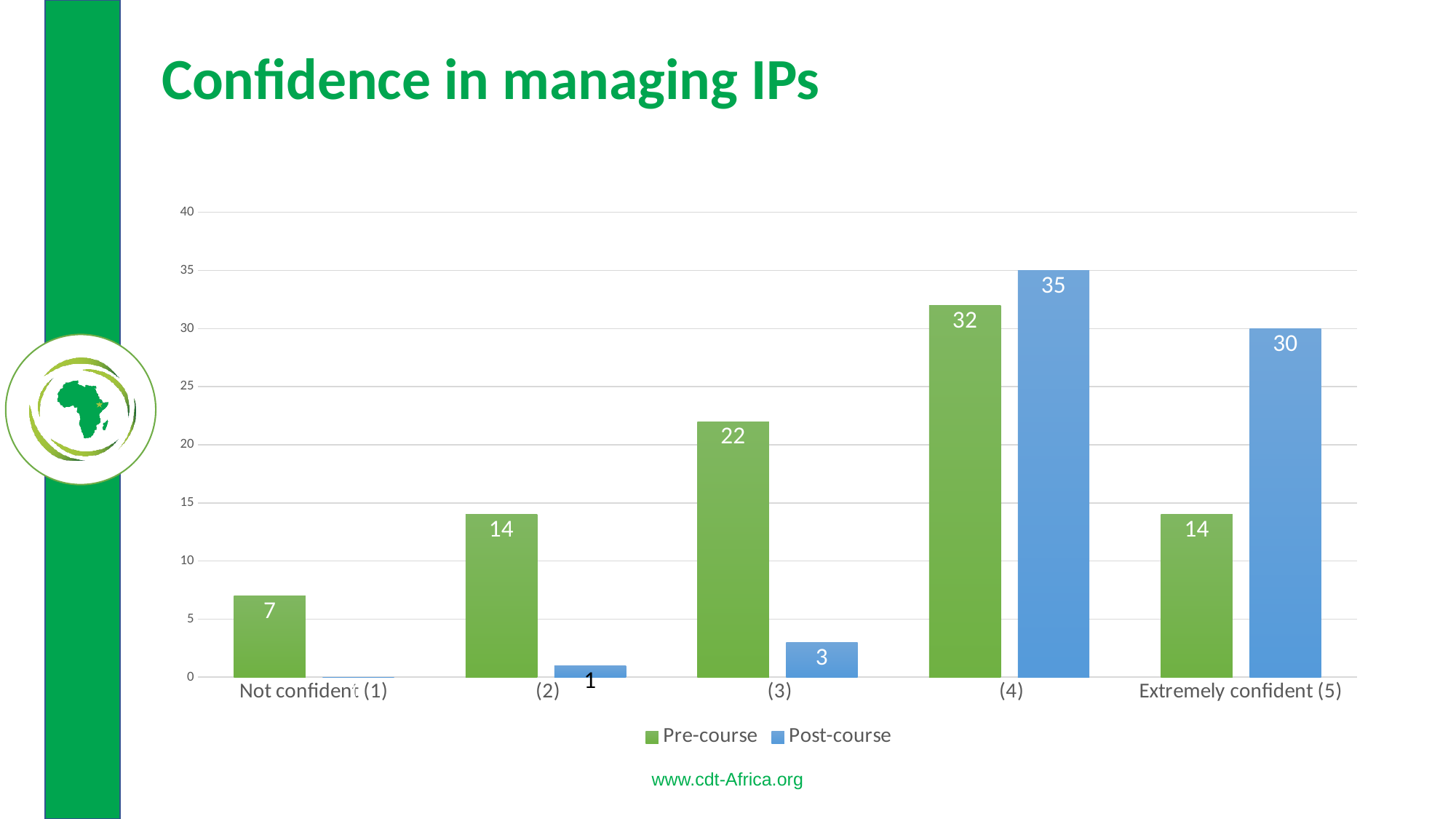
What is the Pre-course value for (3)? 22 What is the Pre-course value for Not confident (1)? 7 Which category has the lowest Pre-course value? Not confident (1) How many series does the legend list? 2 What is the Post-course value for (4)? 35 What is the difference between the Post-course and Pre-course values for Extremely confident (5)? 16 Is the Post-course value for (4) greater or less than 30? greater For (3), which is larger, the Pre-course or the Post-course value? Pre-course How many categories are shown on the x axis? 5 Which category has the highest Pre-course value? (4) What is the Post-course value for Extremely confident (5)? 30 What type of chart is shown on the slide? Bar chart